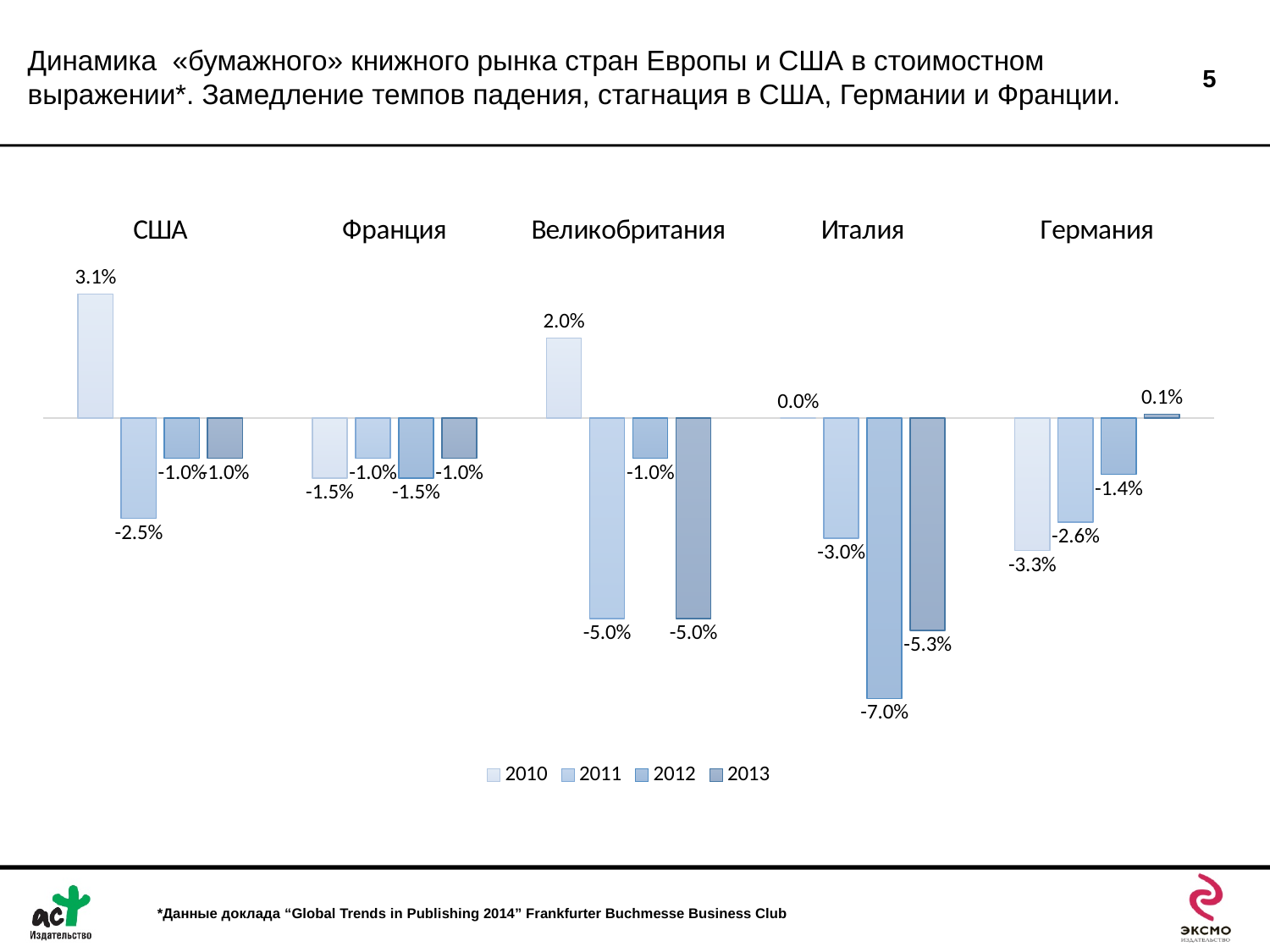
How many countries are shown on the chart? 5 Which country had the highest value in 2010? США What was the value for Италия in 2012? -7.0% Which years are listed in the chart legend? 2010, 2011, 2012, 2013 Which country had the lowest value in 2012? Италия What was the value for Германия in 2013? 0.1% What was the value for США in 2010? 3.1% Which is larger: the 2011 value for Германия or the 2011 value for Италия? Германия What was the value for Великобритания in 2011? -5.0% What type of chart is shown on the slide? Bar chart What is the difference between the 2010 value for США and the 2010 value for Великобритания? 1.1% How many series does the legend list? 4